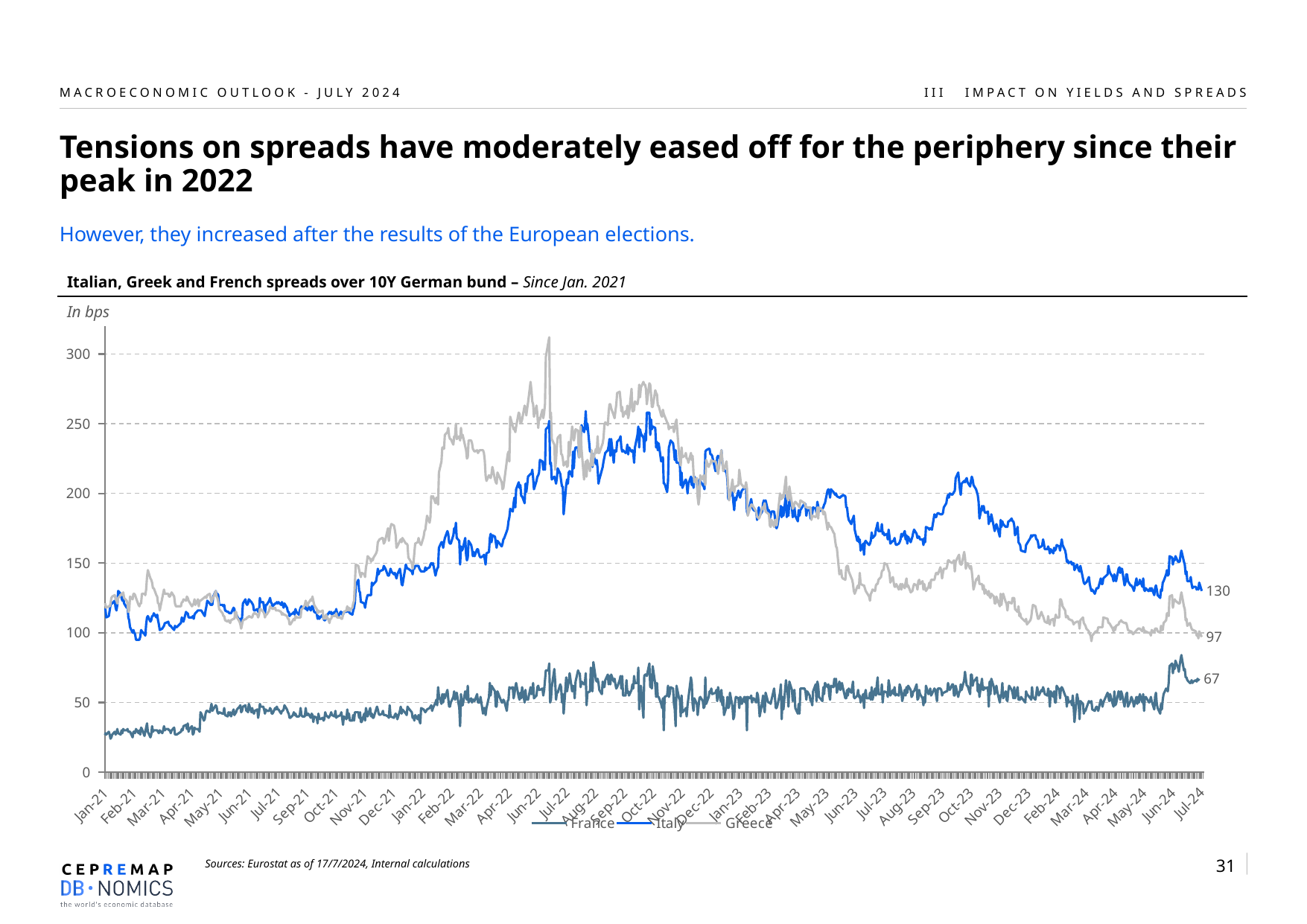
What is the latest value shown for France at the right end of the chart? 67 What is the difference between the latest values for Italy and Greece? 33 How many series does the legend list? 3 What is the latest value shown for Greece at the right end of the chart? 97 Which series has the lowest value at the right end of the chart? France In what unit are the values on the chart expressed? bps Does the Greece series rise or fall between Oct-22 and Jul-24? fall Is the peak value for Greece in mid-2022 greater or less than 300? greater What kind of chart is shown on the slide? line chart What is the latest value shown for Italy at the right end of the chart? 130 At the right end of the chart, is the value for Greece larger or smaller than the value for France? larger Which series has the highest value at the right end of the chart? Italy